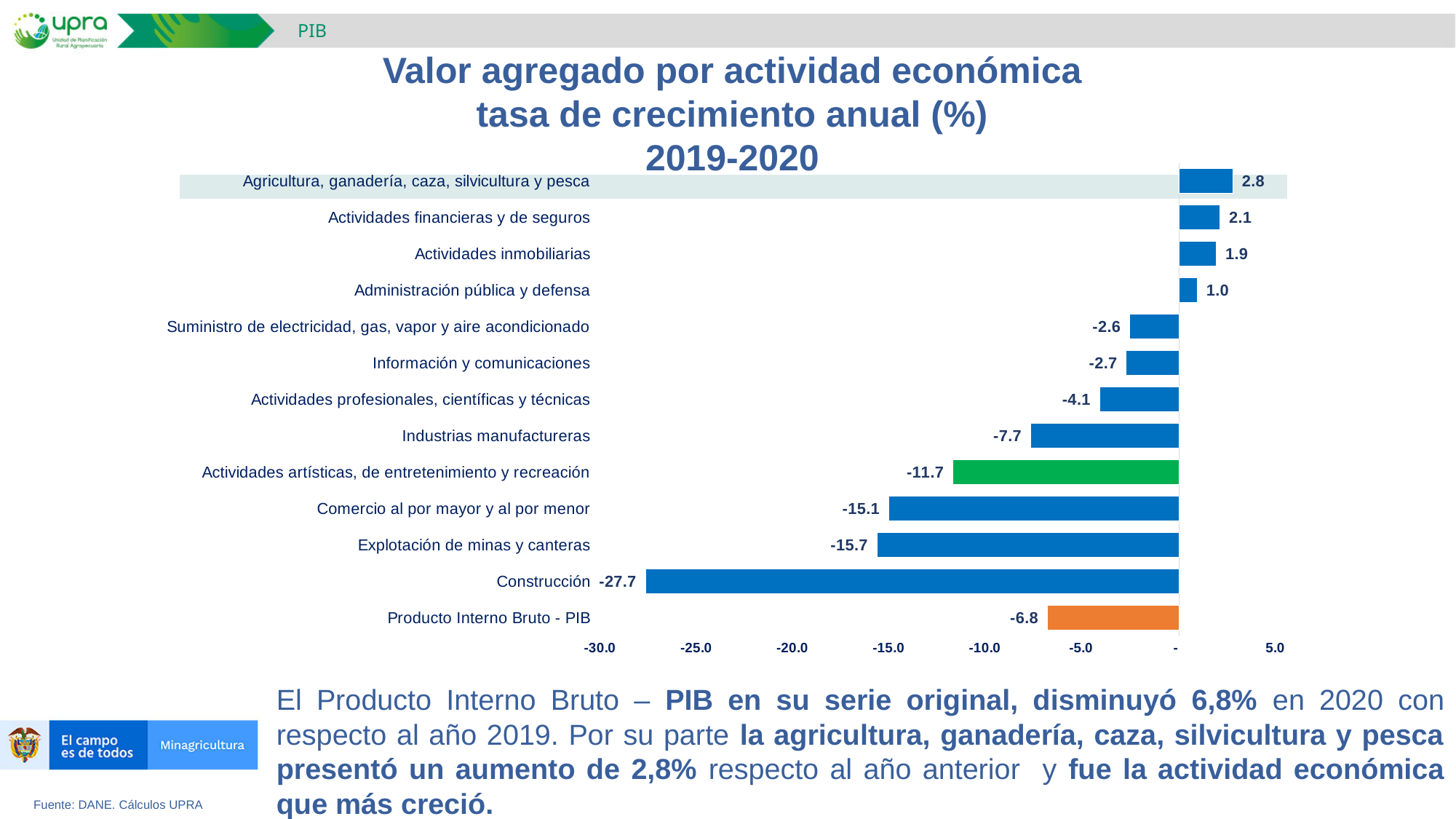
What is the difference between the values for Industrias manufactureras and Actividades profesionales, científicas y técnicas? 3.6 Which category has the highest growth rate? Agricultura, ganadería, caza, silvicultura y pesca What is the difference between the values for Actividades financieras y de seguros and Actividades inmobiliarias? 0.2 Which has a higher growth rate, Comercio al por mayor y al por menor or Explotación de minas y canteras? Comercio al por mayor y al por menor What colour is the bar for Producto Interno Bruto - PIB? Orange What kind of chart is shown on the slide? Bar chart What value is shown for Construcción? -27.7 What value is shown for Actividades artísticas, de entretenimiento y recreación? -11.7 Which category has the lowest growth rate? Construcción What is the growth rate shown for Producto Interno Bruto - PIB? -6.8 How many categories are plotted in the chart? 13 What is the annual growth rate shown for Agricultura, ganadería, caza, silvicultura y pesca? 2.8